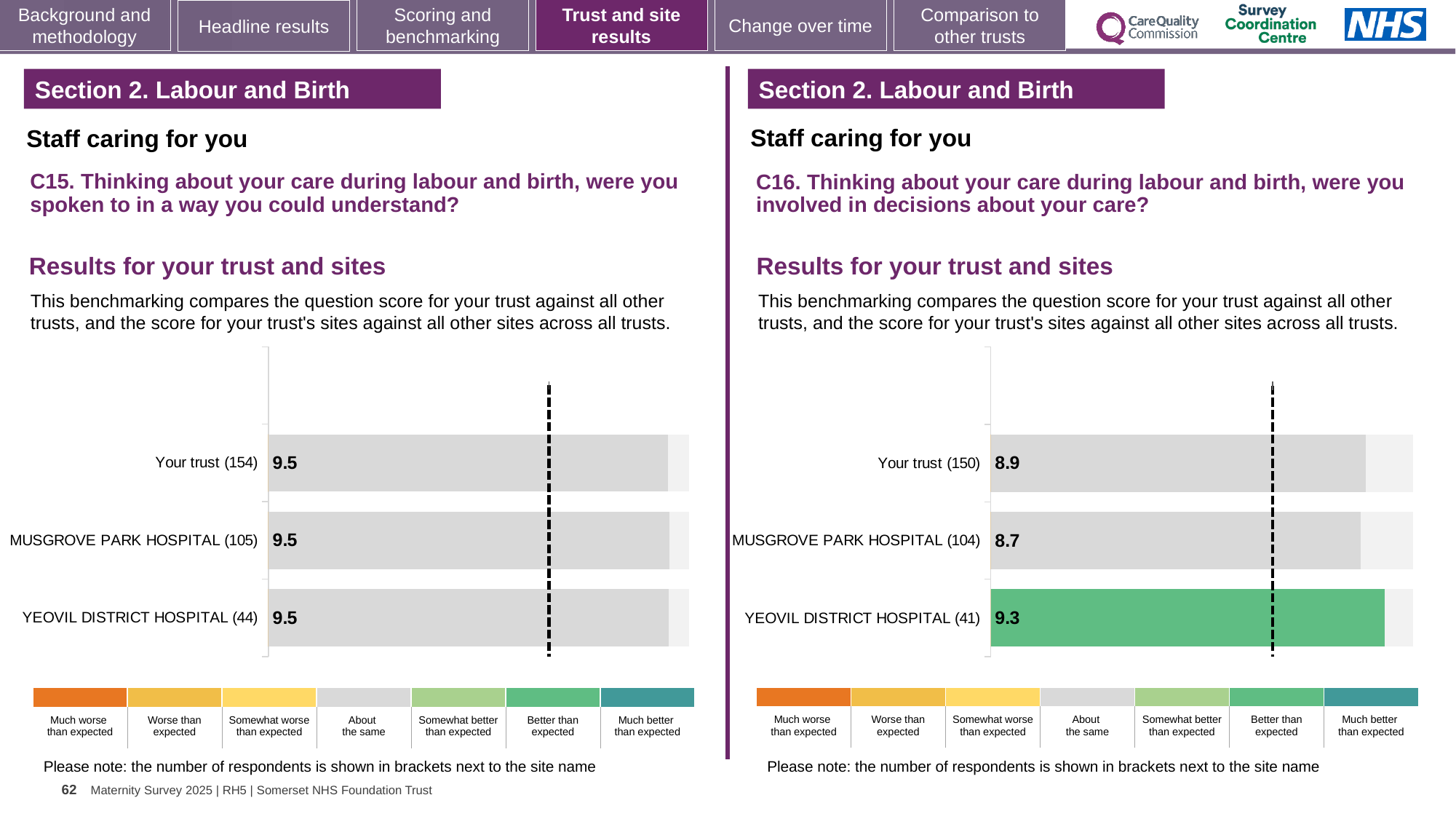
What kind of chart is used in the C16 chart on the right? Bar chart In the C16 chart on the right, which has the larger score, Your trust (150) or YEOVIL DISTRICT HOSPITAL (41)? YEOVIL DISTRICT HOSPITAL (41) In the C15 chart on the left, what is the score for Your trust (154)? 9.5 In the C16 chart on the right, what is the score for MUSGROVE PARK HOSPITAL (104)? 8.7 In the C15 chart on the left, what is the score for YEOVIL DISTRICT HOSPITAL (44)? 9.5 In the C16 chart on the right, what is the score for Your trust (150)? 8.9 In the C16 chart on the right, which site or trust has the highest score? YEOVIL DISTRICT HOSPITAL (41) In the C16 chart on the right, what is the difference between the scores for YEOVIL DISTRICT HOSPITAL (41) and MUSGROVE PARK HOSPITAL (104)? 0.6 In the C16 chart on the right, what is the score for YEOVIL DISTRICT HOSPITAL (41)? 9.3 In the C16 chart on the right, which site or trust has the lowest score? MUSGROVE PARK HOSPITAL (104) How many bars are shown in the C15 chart on the left? 3 In the C16 chart on the right, which bar is coloured green rather than grey? YEOVIL DISTRICT HOSPITAL (41)